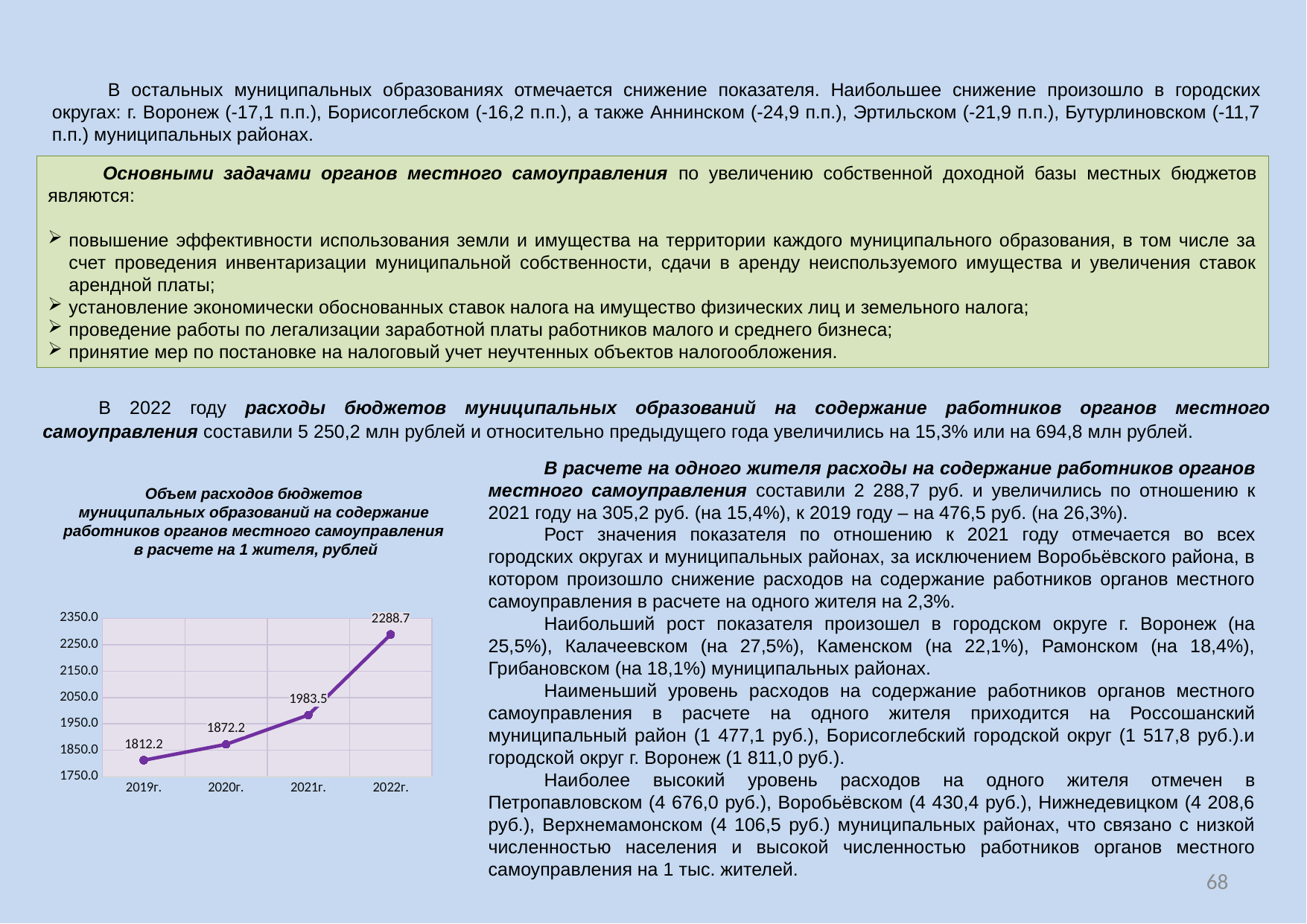
Which is larger, the value for 2020г. or the value for 2021г.? 2021г. Do the values rise or fall from 2019г. to 2022г.? rise What type of chart is shown on the slide? line chart What is the value for 2020г. on the chart? 1872.2 Which year has the lowest value on the chart? 2019г. What is the difference between the values for 2022г. and 2021г.? 305.2 Which year has the highest value on the chart? 2022г. How many data points are plotted on the chart? 4 What is the difference between the values for 2022г. and 2019г.? 476.5 What is the value for 2019г. on the chart? 1812.2 What is the value for 2021г. on the chart? 1983.5 What is the value for 2022г. on the chart? 2288.7